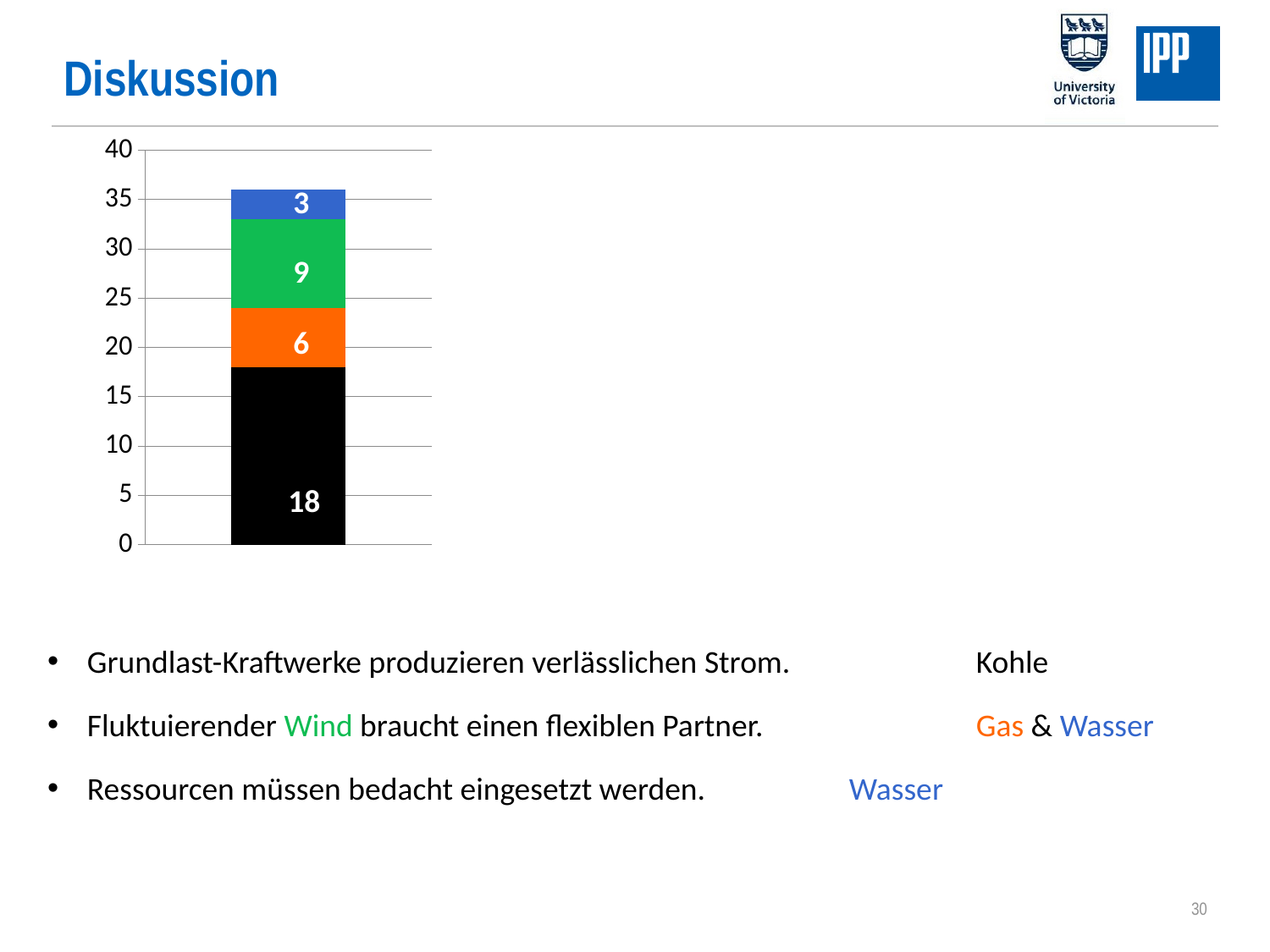
What is the total of all segments in the stacked bar? 36 What is the value of the blue segment at the top of the stacked bar? 3 What kind of chart is shown on the slide? stacked bar chart Which is larger, the green segment or the orange segment? the green segment What is the value of the black segment at the bottom of the stacked bar? 18 How many bars are plotted in the chart? 1 Which segment of the stacked bar has the largest value? the black segment (18) What is the value of the green segment of the stacked bar? 9 What is the value of the orange segment of the stacked bar? 6 Which segment of the stacked bar has the smallest value? the blue segment (3) Is the top of the stacked bar greater or less than 30 on the y axis? greater What is the difference between the black segment and the orange segment? 12